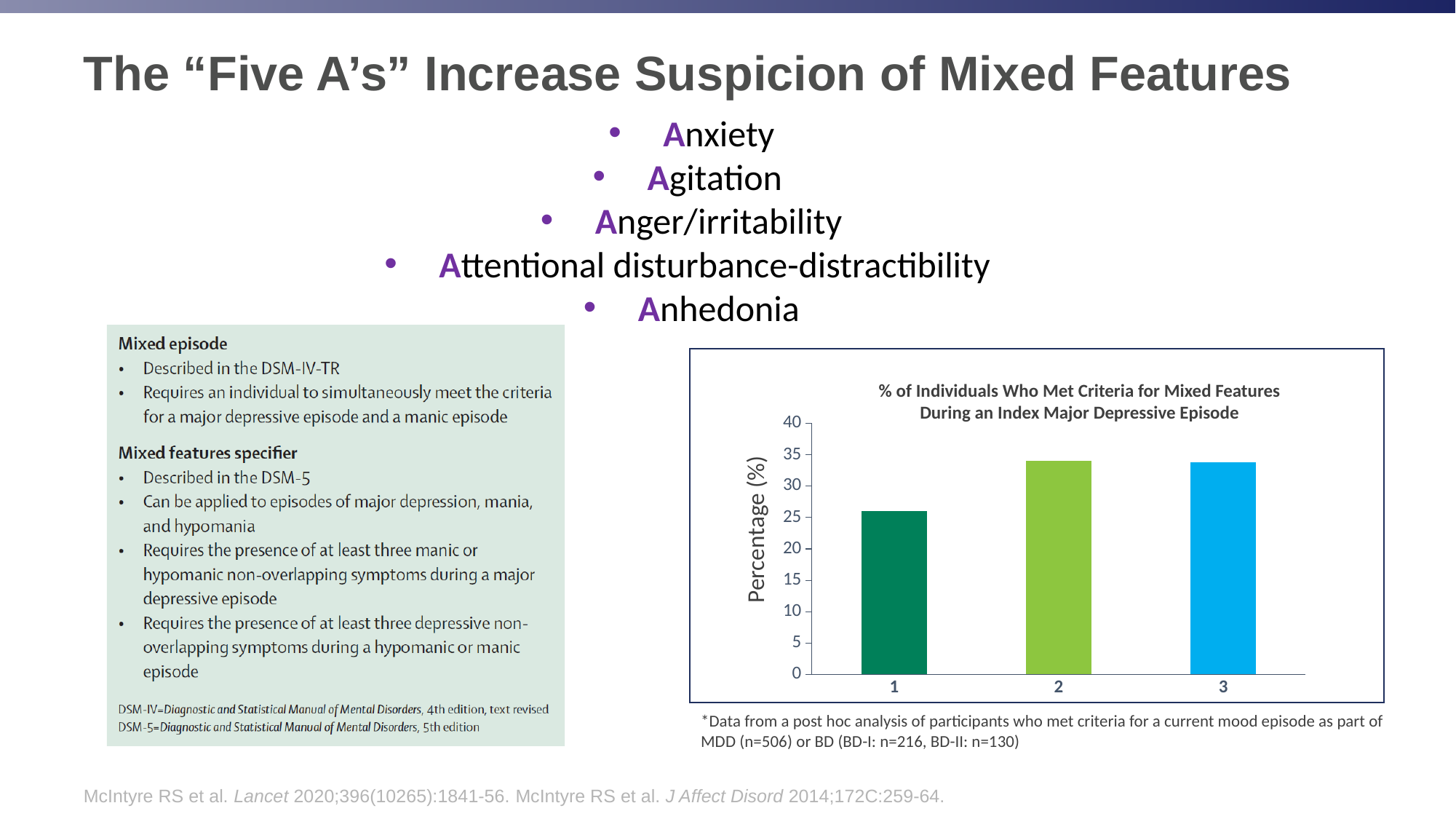
How many bars are plotted in the chart? 3 Which is larger, the value for category 1 or the value for category 2? 2 What is the label on the vertical axis of the chart? Percentage (%) Is the value for category 2 greater or less than 35? less Which category has the lowest value in the chart? 1 Which is larger, the value for category 3 or the value for category 1? 3 What kind of chart is shown on the slide? bar chart Is the value for category 2 greater or less than 30? greater Is the value for category 1 greater or less than 25? greater What is the title of the chart? % of Individuals Who Met Criteria for Mixed Features During an Index Major Depressive Episode